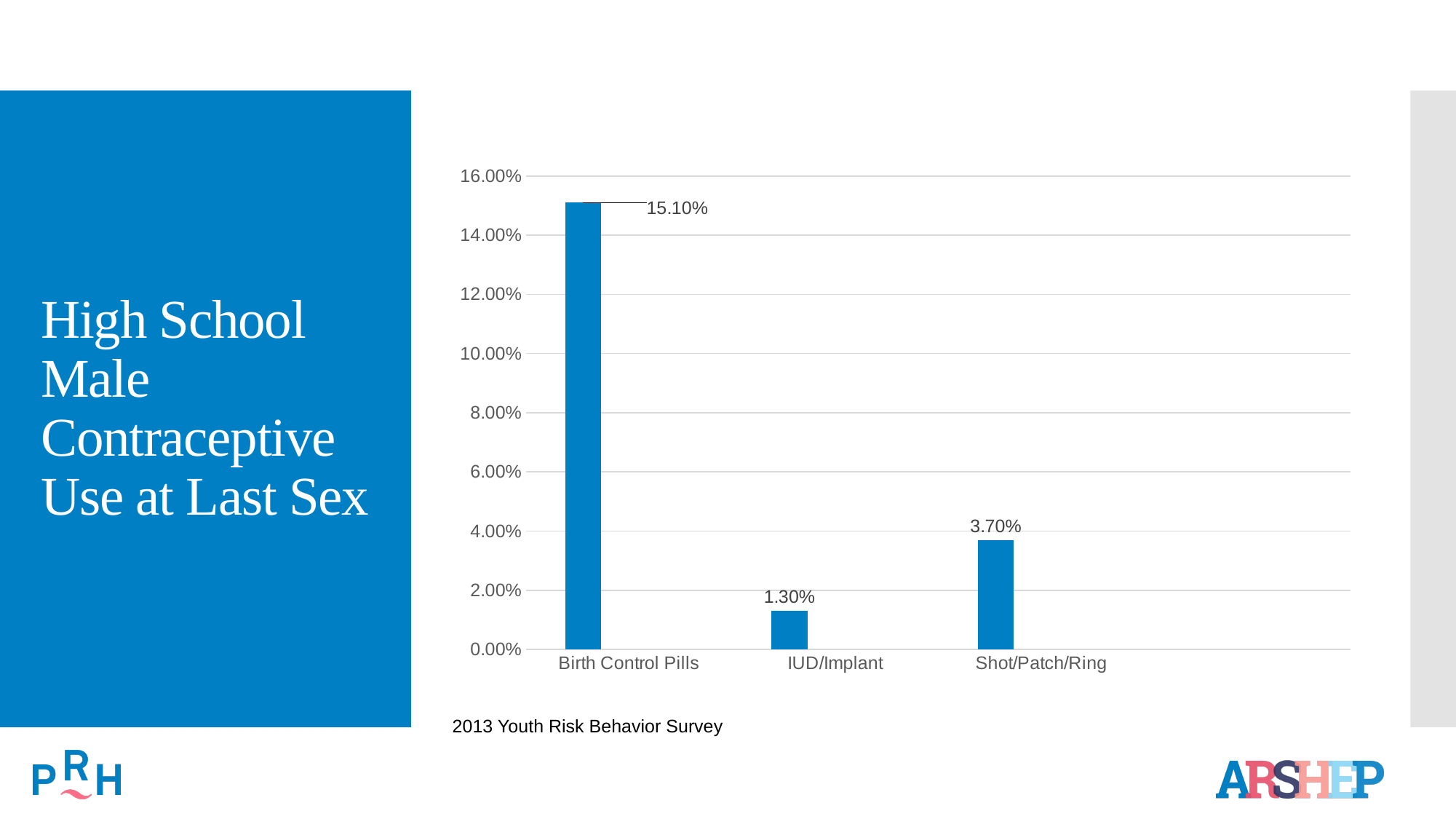
Which is larger, the value for Shot/Patch/Ring or the value for IUD/Implant? Shot/Patch/Ring What data source is cited below the chart? 2013 Youth Risk Behavior Survey What is the value for Birth Control Pills? 15.10% How many categories are shown on the x axis? 3 What is the difference between the values for Birth Control Pills and Shot/Patch/Ring? 11.40% What is the value for IUD/Implant? 1.30% Which category has the lowest value? IUD/Implant What kind of chart is shown on the slide? bar chart Is the value for Birth Control Pills greater or less than 14.00%? greater What is the difference between the values for Shot/Patch/Ring and IUD/Implant? 2.40% What is the value for Shot/Patch/Ring? 3.70% Which category has the highest value? Birth Control Pills